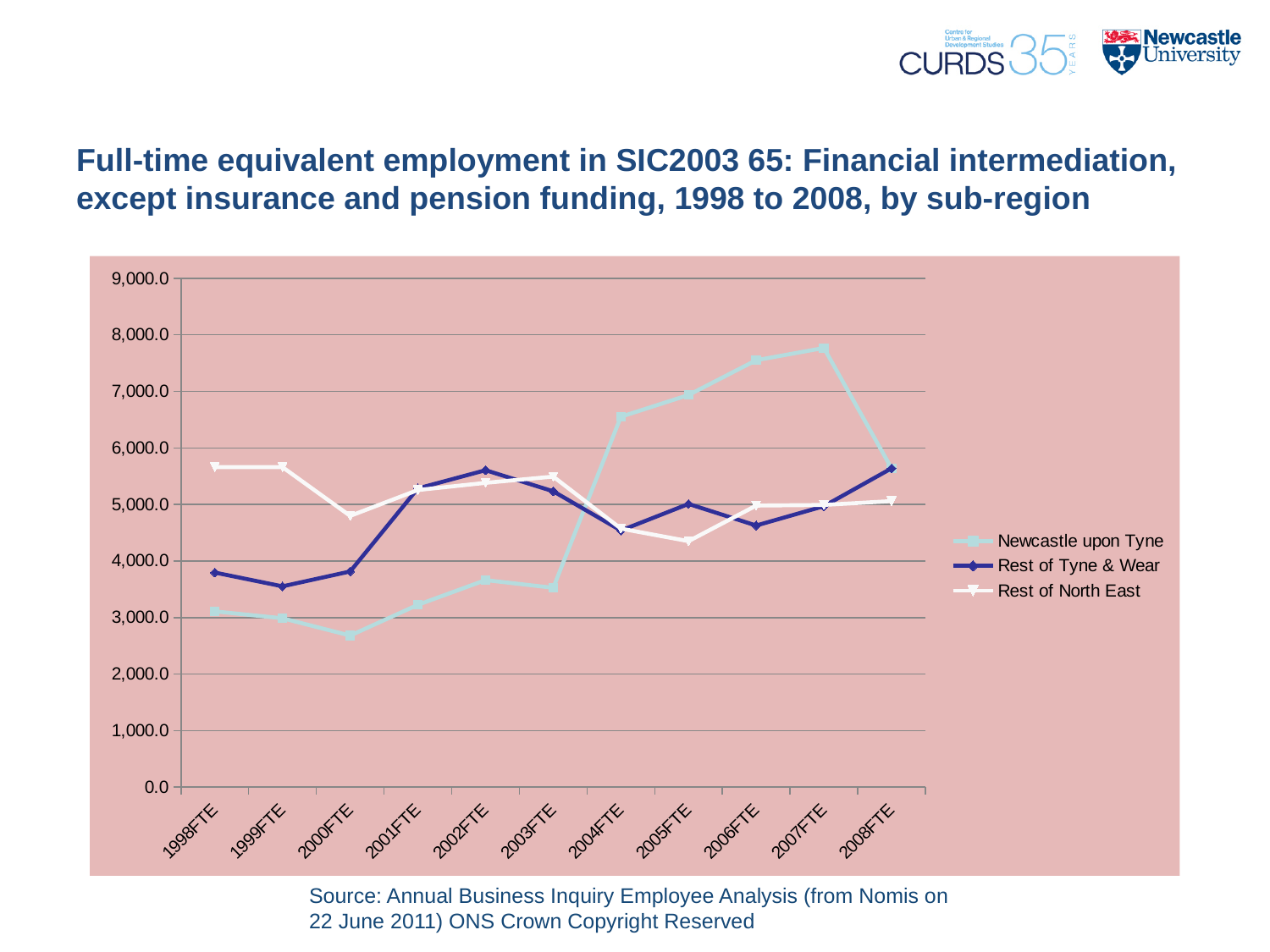
What are the three series named in the legend? Newcastle upon Tyne, Rest of Tyne & Wear, Rest of North East In 2006FTE, which series has the larger value: Newcastle upon Tyne or Rest of Tyne & Wear? Newcastle upon Tyne In which year does the Newcastle upon Tyne series reach its highest value? 2007FTE How many series does the legend list? 3 What kind of chart is shown on the slide? Line chart How many years (points) are plotted along the x axis? 11 In 1998FTE, which series has the larger value: Rest of North East or Newcastle upon Tyne? Rest of North East Does the Newcastle upon Tyne series rise or fall from 2004FTE to 2007FTE? Rise Is the value for Rest of Tyne & Wear in 1998FTE greater or less than 4,000.0? less In which year does the Newcastle upon Tyne series reach its lowest value? 2000FTE Is the value for Newcastle upon Tyne in 2000FTE greater or less than 3,000.0? less Is the value for Newcastle upon Tyne in 2007FTE greater or less than 7,000.0? greater